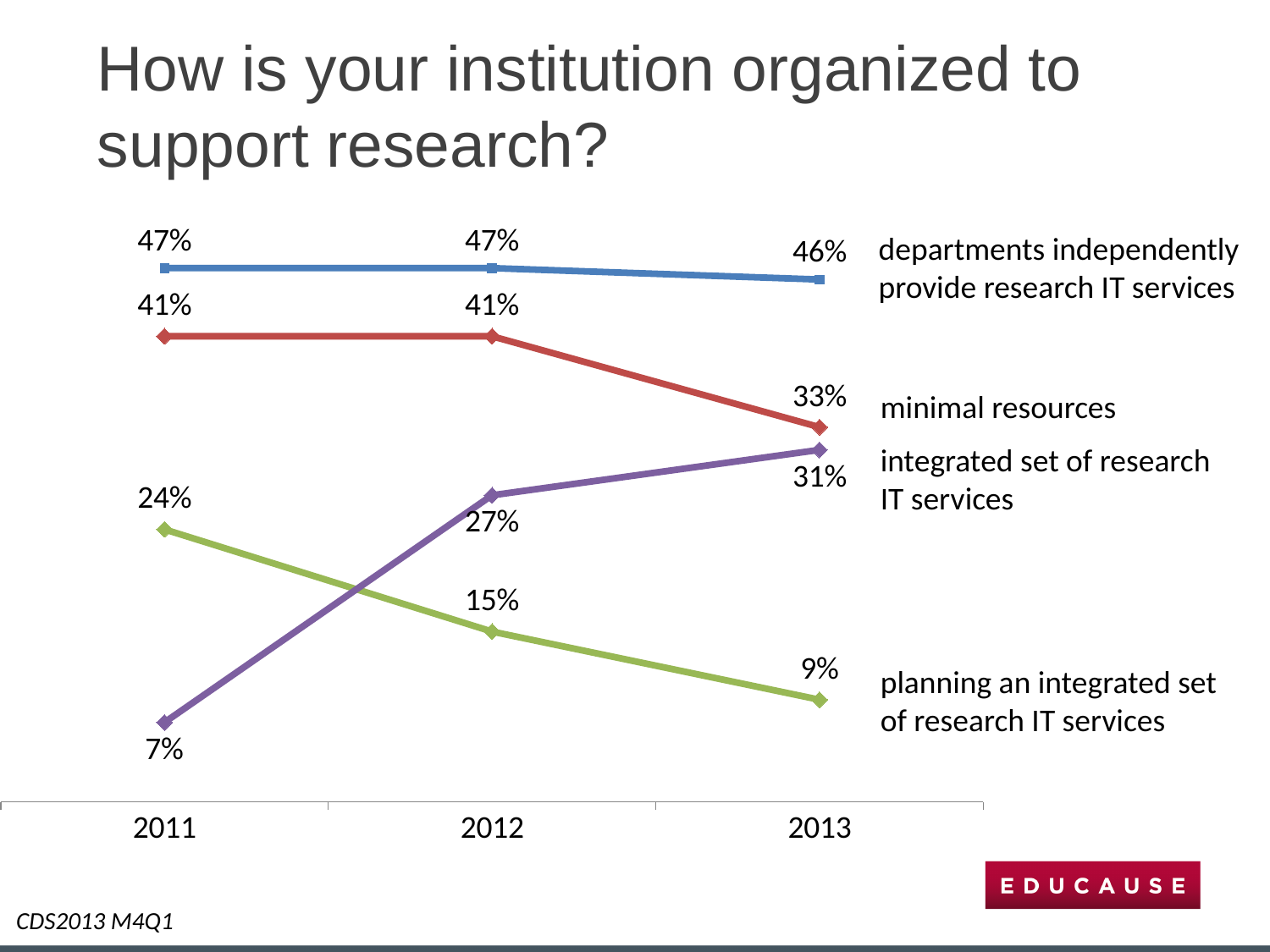
By how many percentage points did 'minimal resources' fall from 2012 to 2013? 8 In 2013, which was larger: 'minimal resources' or 'integrated set of research IT services'? minimal resources What was the value for 'integrated set of research IT services' in 2011? 7% What was the value for 'planning an integrated set of research IT services' in 2013? 9% How many years are shown on the x axis? 3 Does the value for 'planning an integrated set of research IT services' rise or fall from 2011 to 2013? fall Which series had the highest value in 2013? departments independently provide research IT services Which series had the lowest value in 2011? integrated set of research IT services What percentage of institutions reported that departments independently provide research IT services in 2013? 46% What was the value for 'minimal resources' in 2012? 41% By how many percentage points did 'integrated set of research IT services' rise from 2011 to 2013? 24 What kind of chart is shown on the slide? line chart